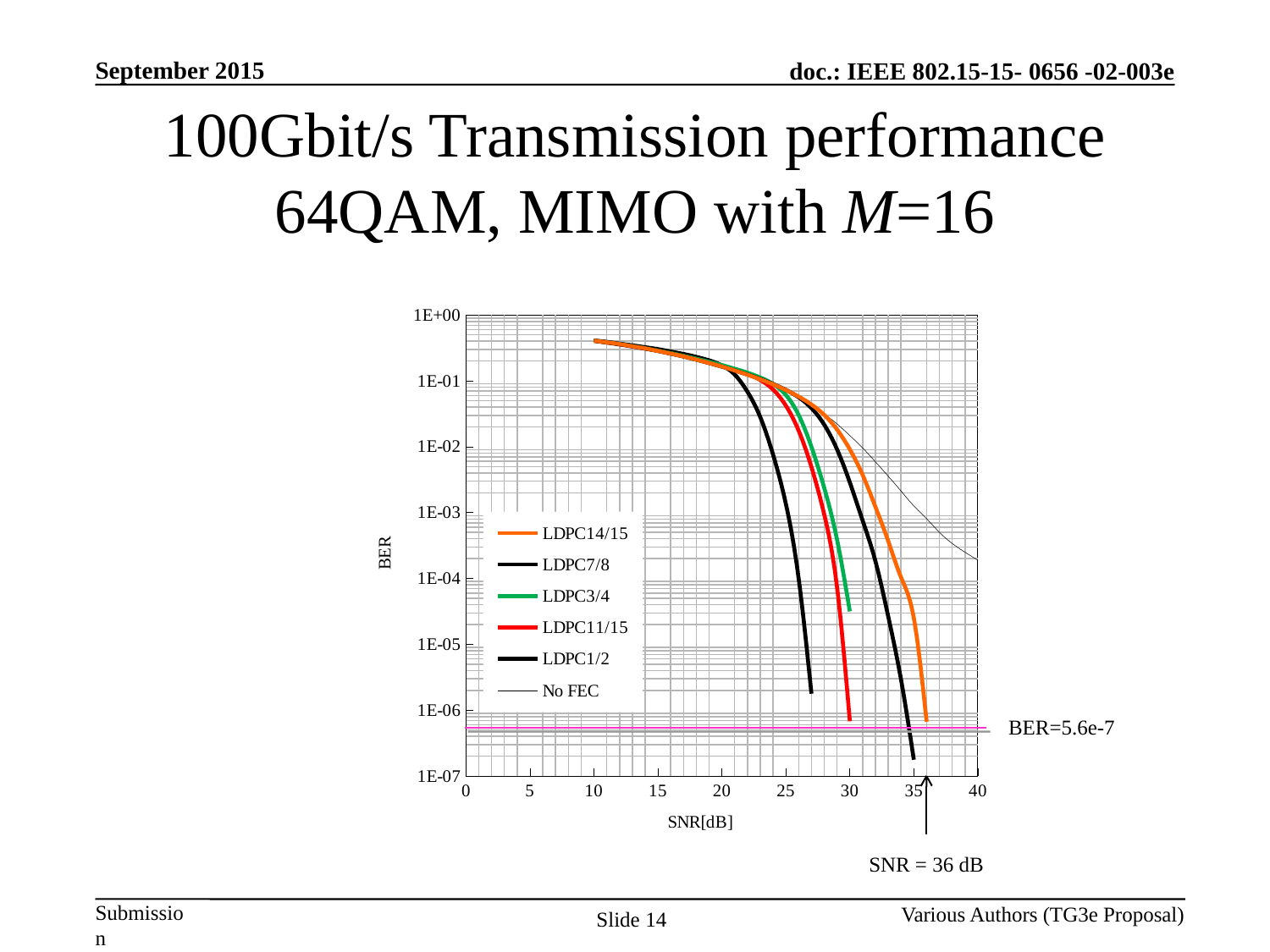
What is the label of the x axis of the chart? SNR[dB] What BER value is marked by the horizontal line annotation on the chart? BER=5.6e-7 What kind of chart is shown on the slide? line chart As SNR increases along the x axis, does the BER of the LDPC curves rise or fall? fall Which LDPC series reaches a BER below 1E-05 at the lowest SNR? LDPC1/2 At SNR = 30 dB, which series has the lower BER, LDPC11/15 or LDPC14/15? LDPC11/15 At SNR = 35 dB, which series has the highest BER? No FEC How many series does the chart legend list? 6 Is the BER of LDPC14/15 at SNR = 15 dB greater or less than 1E-01? greater What is the label of the y axis of the chart? BER What SNR value is marked by the arrow annotation below the chart? SNR = 36 dB